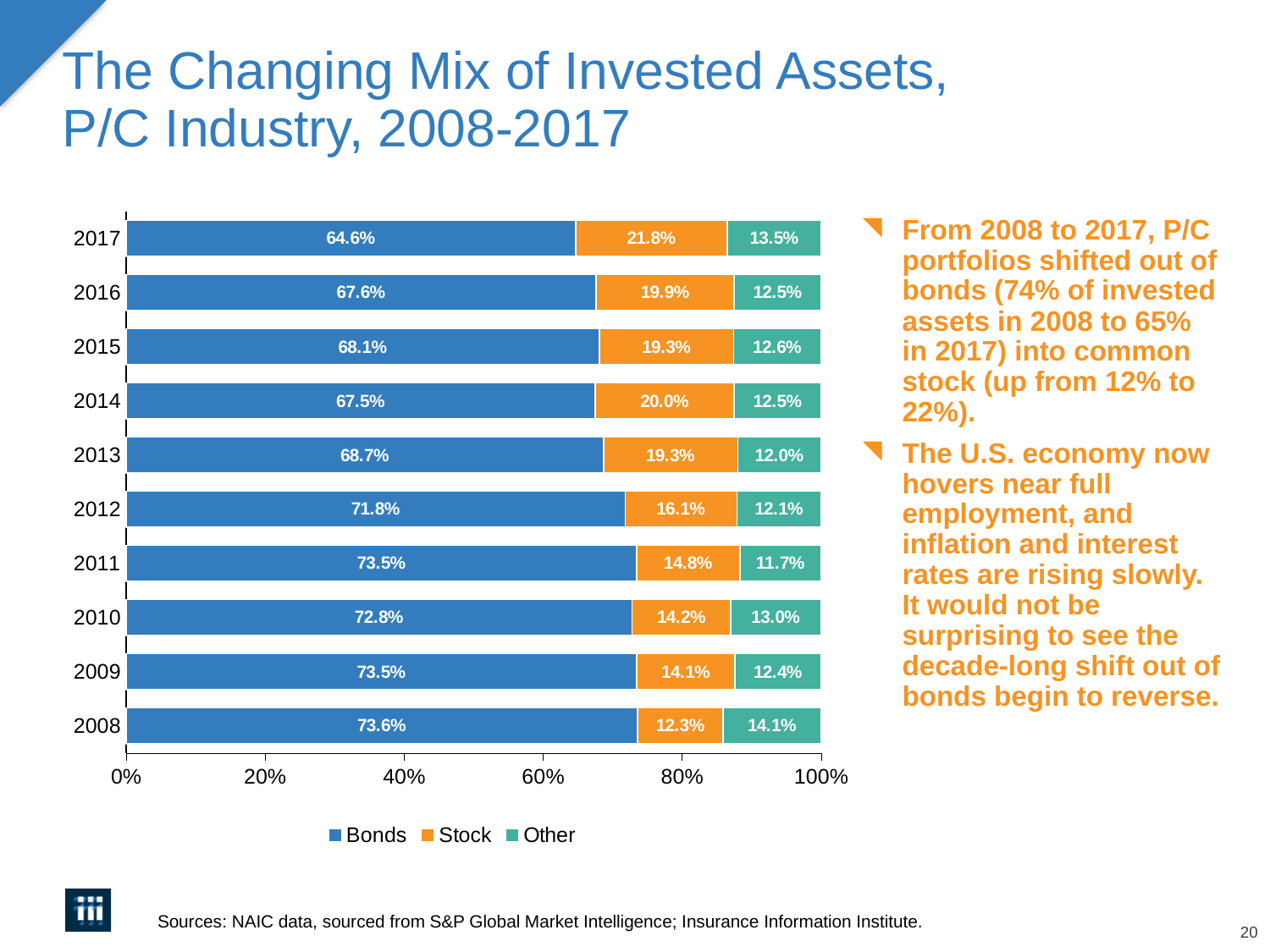
Is the Bonds share in 2012 greater or less than 60%? greater What share of invested assets was in Bonds in 2017? 64.6% How many series does the legend list? 3 By how many percentage points did the Bonds share fall from 2008 to 2017? 9.0 percentage points What was the Other share in 2010? 13.0% In which year was the Bonds share the lowest? 2017 In which year was the Stock share the highest? 2017 What is the difference between the Stock share in 2017 and in 2016? 1.9 percentage points What kind of chart is shown on the slide? Stacked bar chart In 2008, which was larger: the Stock share or the Other share? Other What was the Stock share in 2008? 12.3% How many years are shown on the chart? 10